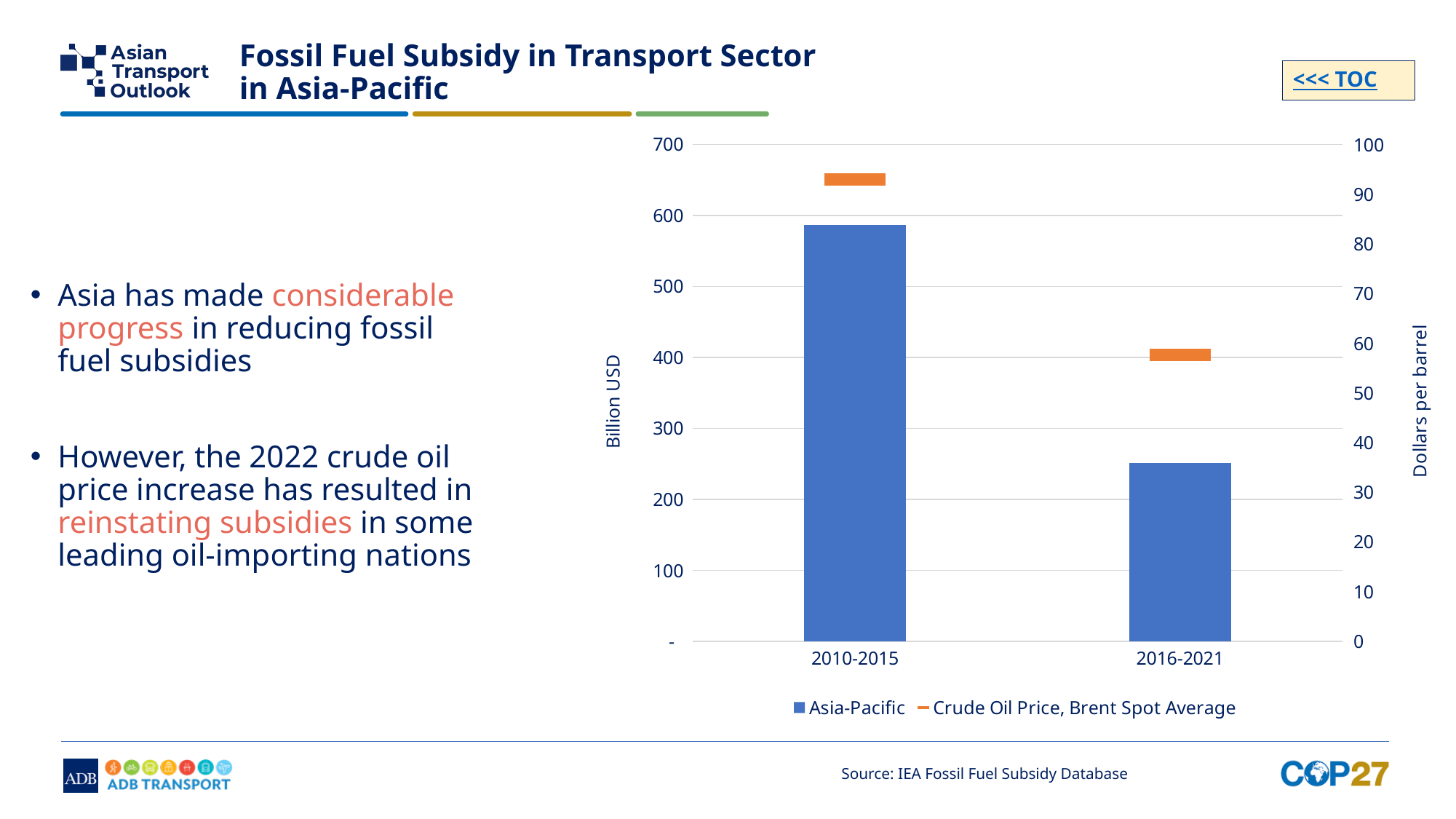
Which period has the higher Asia-Pacific fossil fuel subsidy bar? 2010-2015 Do the Asia-Pacific subsidy values rise or fall from 2010-2015 to 2016-2021? fall Which period has the lower Asia-Pacific fossil fuel subsidy bar? 2016-2021 How many series does the chart legend list? 2 Is the Asia-Pacific subsidy bar for 2016-2021 greater or less than 300 billion USD? less Is the Crude Oil Price, Brent Spot Average marker for 2010-2015 greater or less than 80 dollars per barrel? greater Is the Crude Oil Price, Brent Spot Average marker for 2016-2021 greater or less than 70 dollars per barrel? less Which period has the higher Crude Oil Price, Brent Spot Average: 2010-2015 or 2016-2021? 2010-2015 How many time periods are shown on the x axis of the chart? 2 What is the label of the left vertical axis of the chart? Billion USD What kind of chart is shown on the slide? combination bar and line chart